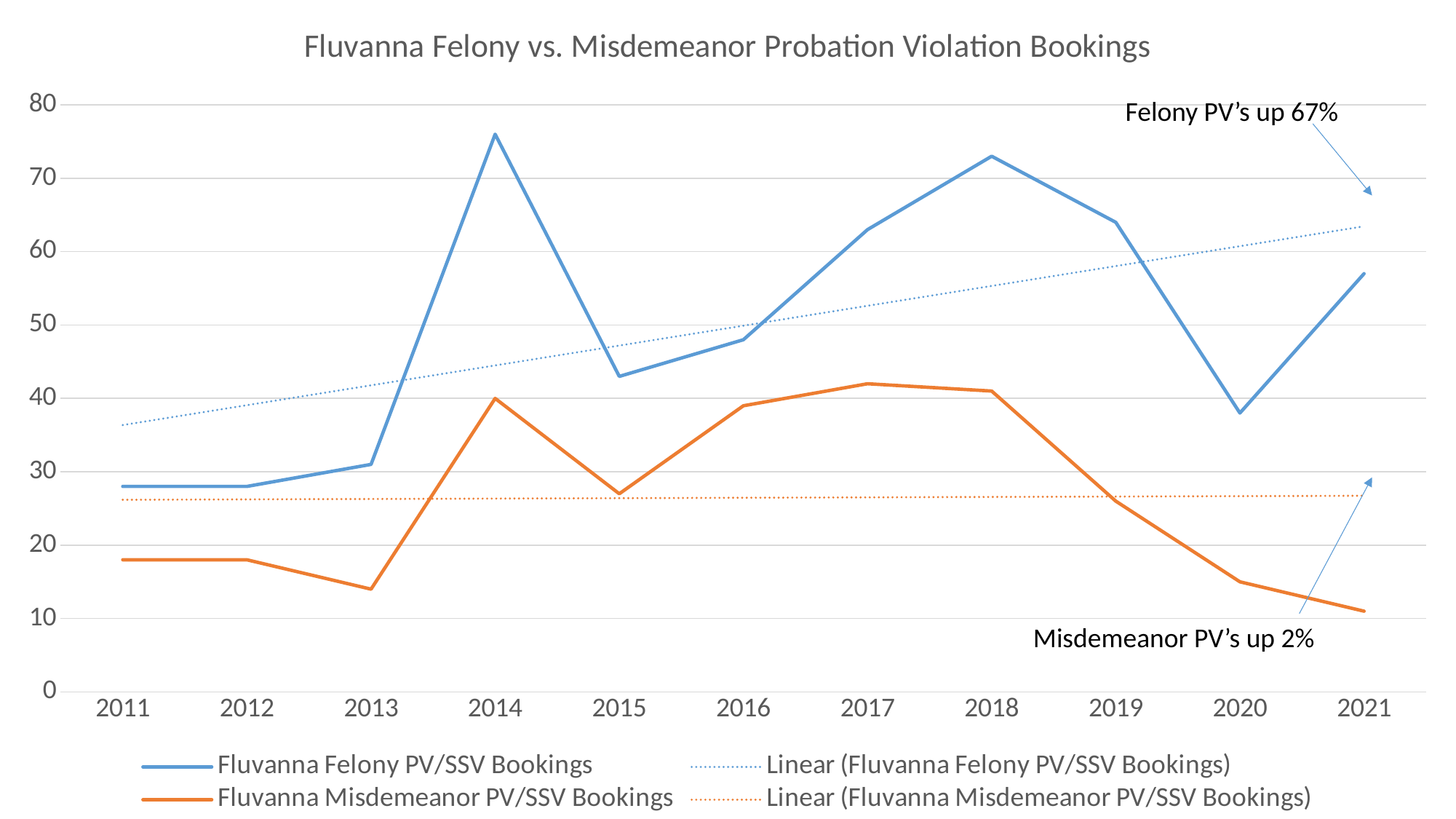
Is the value for Fluvanna Felony PV/SSV Bookings in 2014 greater or less than 70? greater Is the value for Fluvanna Felony PV/SSV Bookings in 2020 greater or less than 40? less How many entries does the legend list? 4 Do Fluvanna Misdemeanor PV/SSV Bookings rise or fall from 2018 to 2021? fall In which year do Fluvanna Felony PV/SSV Bookings reach their highest value? 2014 In 2021, which series has the larger value: Fluvanna Felony PV/SSV Bookings or Fluvanna Misdemeanor PV/SSV Bookings? Fluvanna Felony PV/SSV Bookings What kind of chart is shown on the slide? line chart What is the title of the chart? Fluvanna Felony vs. Misdemeanor Probation Violation Bookings Is the value for Fluvanna Misdemeanor PV/SSV Bookings in 2017 greater or less than 30? greater In which year do Fluvanna Misdemeanor PV/SSV Bookings reach their lowest value? 2021 How many years are shown on the x axis? 11